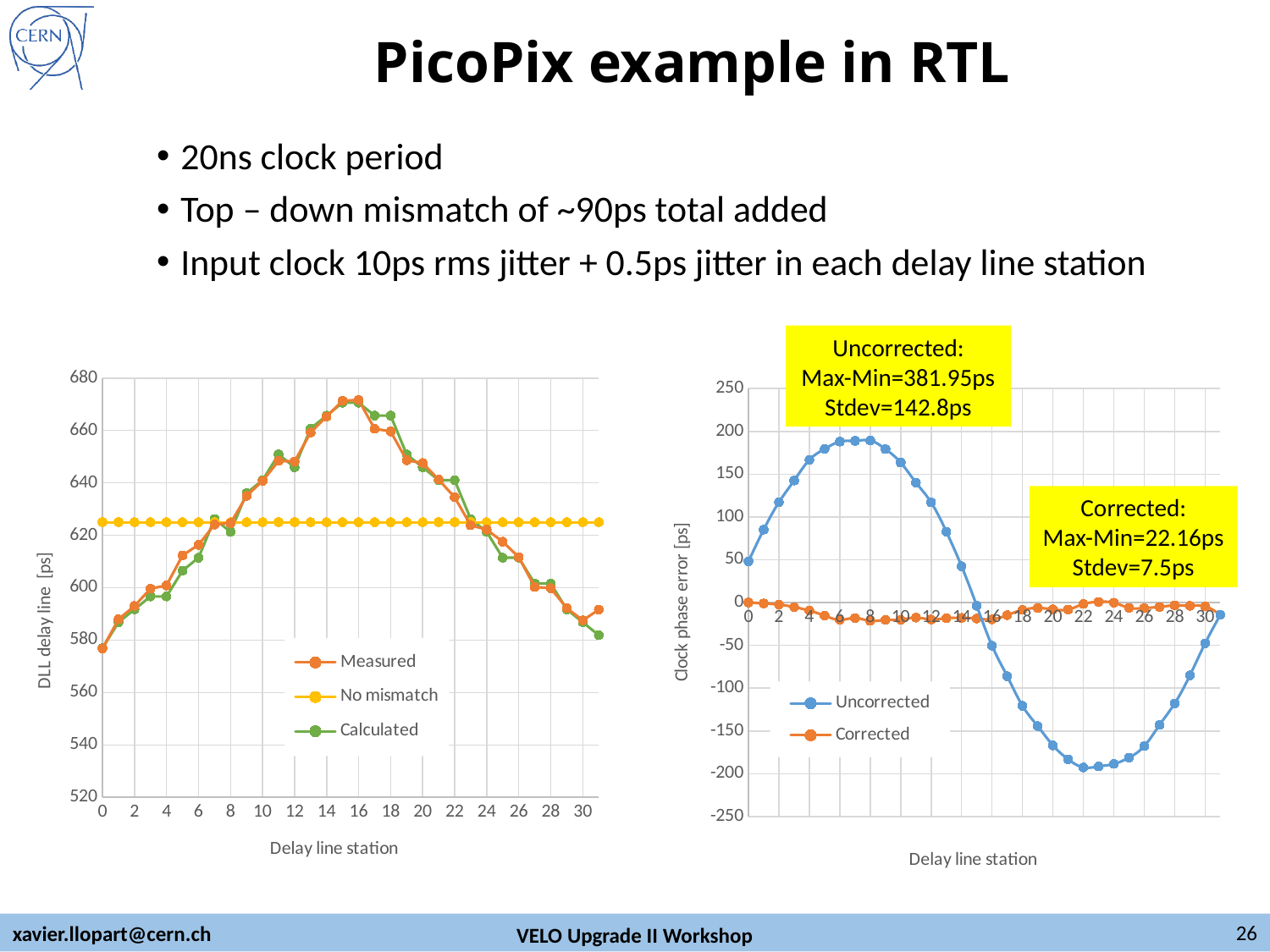
On the right chart, is the Uncorrected value at delay line station 22 greater or less than -150? less On the left chart, is the Measured value at delay line station 0 greater or less than 580? less On the left chart, is the No mismatch value at delay line station 10 greater or less than 620? greater On the left chart, at which delay line station is the Measured series lowest? 0 On the left chart, how many series does the legend list? 3 What kind of chart is the left chart? Line chart On the right chart, how many series does the legend list? 2 On the right chart, which series has the larger value at delay line station 6, Uncorrected or Corrected? Uncorrected On the left chart, does the Measured series rise or fall between delay line station 0 and station 15? rise What is the y-axis title of the right chart? Clock phase error [ps]